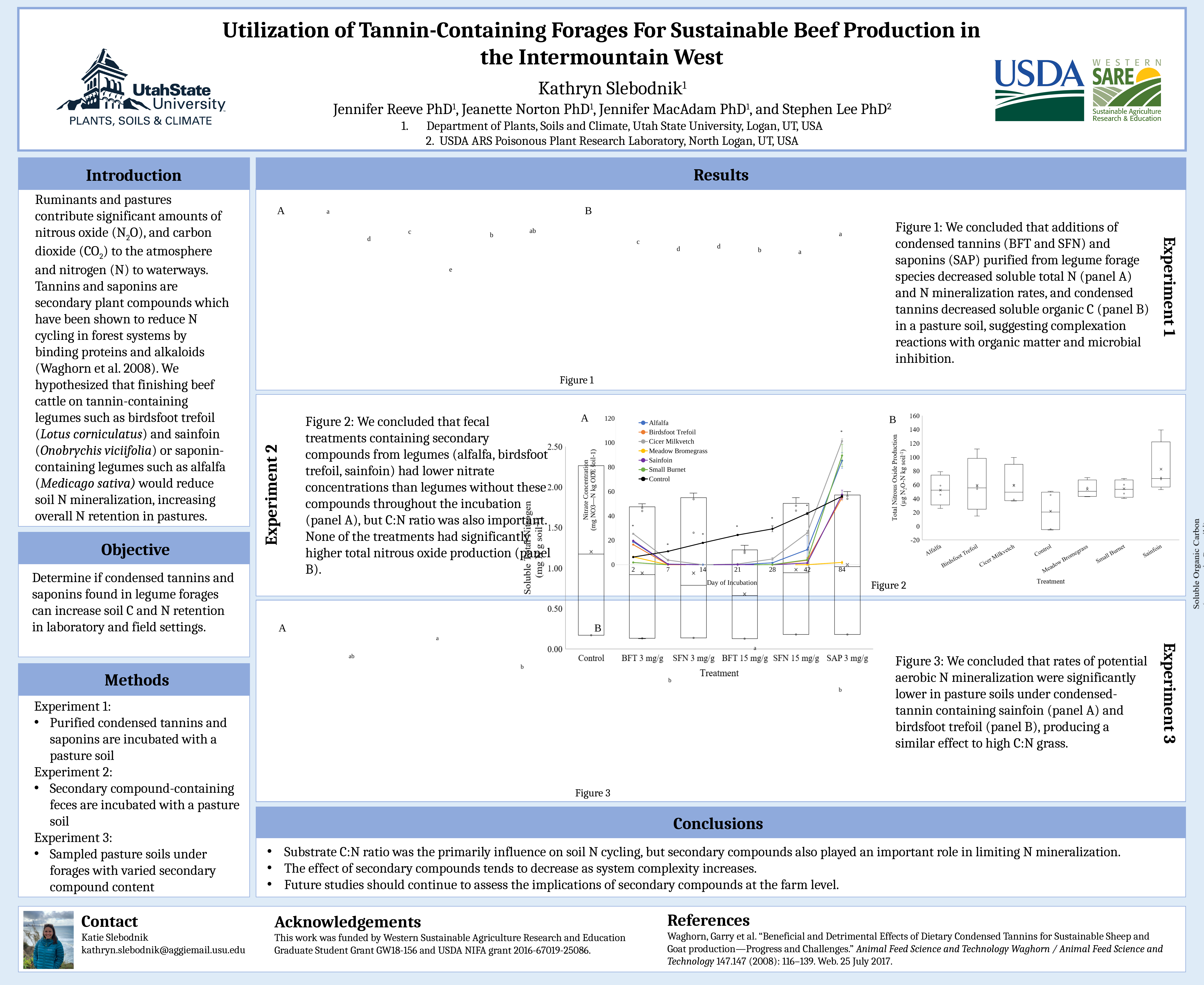
In Figure 2 panel B, which treatment has the lowest median total nitrous oxide production? Control In Figure 2 panel A, what is the last day of incubation shown on the x axis? 84 In Figure 2 panel A, which series is drawn in black? Control In Figure 2 panel A, what kind of chart is shown? line chart In the Soluble Total Nitrogen box plot, how many treatments are shown on the x axis? 6 In Figure 2 panel A, is the Meadow Bromegrass value at day 84 greater or less than 20? less In Figure 2 panel B, which treatment reaches the highest total nitrous oxide production? Sainfoin In Figure 2 panel A, how many days of incubation are marked on the x axis? 7 In Figure 2 panel A, does the Control line rise or fall from day 2 to day 84? rise In Figure 2 panel B, how many treatments are shown on the x axis? 7 In Figure 2 panel A, how many series does the legend list? 7 In Figure 2 panel A, is the Cicer Milkvetch value at day 84 greater or less than 80? greater